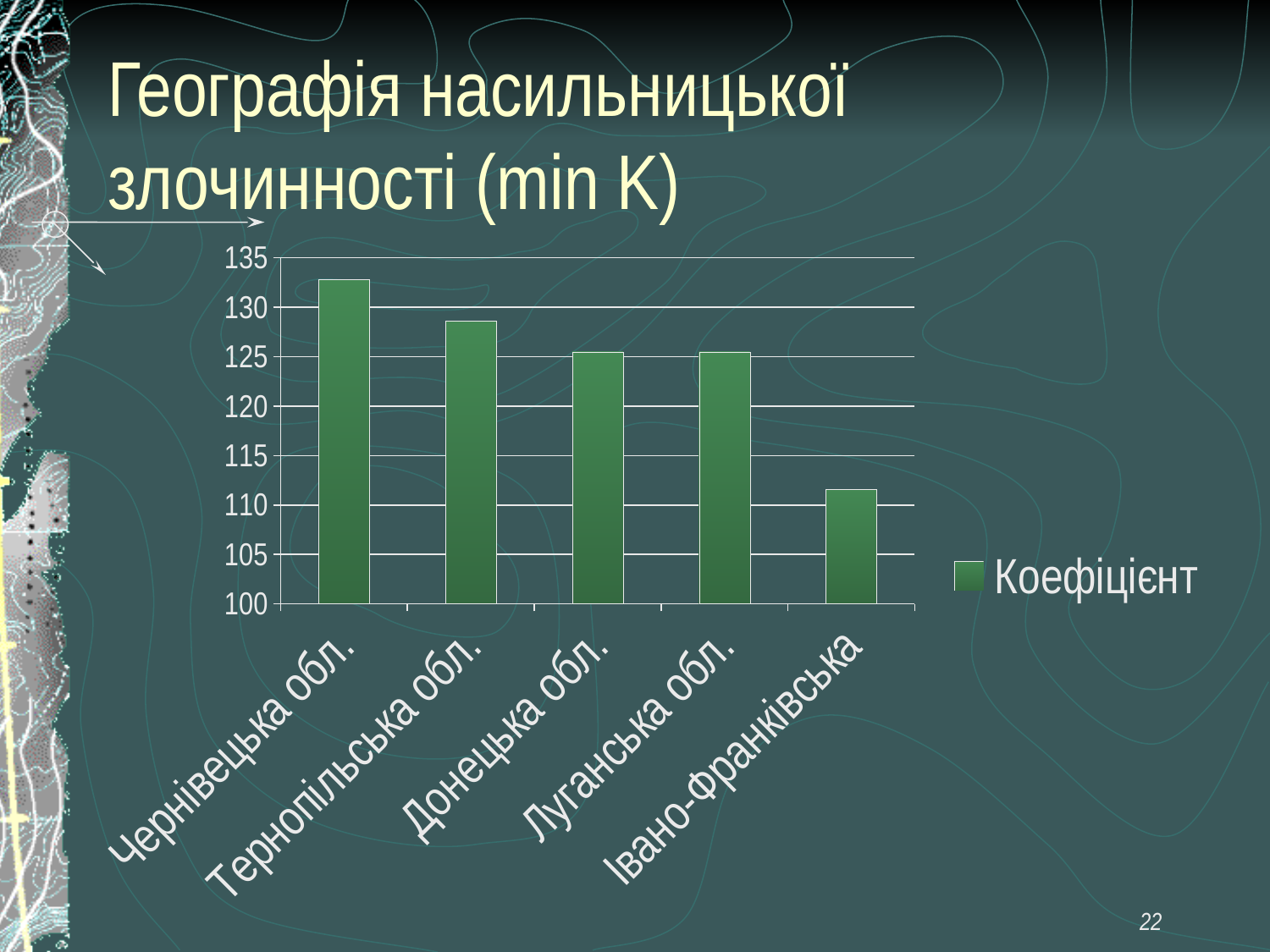
How many series does the chart legend list? 1 Is the value for Тернопільська обл. greater or less than 125? greater Do the values rise or fall from left to right along the x axis? fall What kind of chart is shown on the slide? bar chart Is the value for Донецька обл. greater or less than 130? less How many regions (categories) are shown on the x axis of the chart? 5 Which has the larger value, Чернівецька обл. or Тернопільська обл.? Чернівецька обл. Is the value for Чернівецька обл. greater or less than 130? greater Which region has the lowest value in the chart? Івано-Франківська Which region has the highest value in the chart? Чернівецька обл. What is the name of the series shown in the chart legend? Коефіцієнт